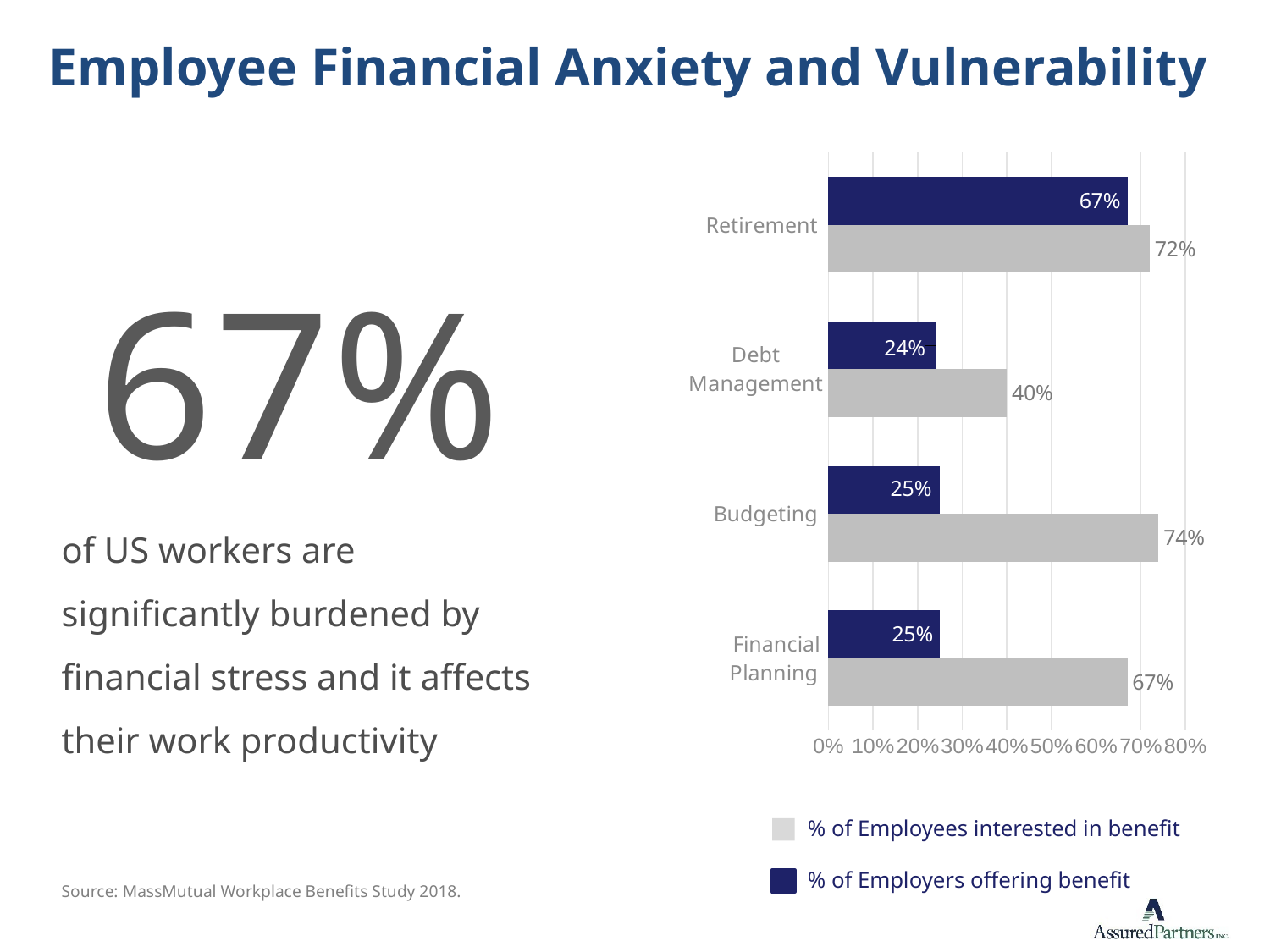
What percentage of employees are interested in a debt management benefit? 40% What is the difference between the percentage of employees interested in a retirement benefit and the percentage of employers offering it? 5% How many series does the chart legend list? 2 Which is larger for Financial Planning: the percentage of employees interested or the percentage of employers offering the benefit? % of Employees interested in benefit Which category has the highest percentage of employers offering the benefit? Retirement What percentage of employers offer a retirement benefit? 67% What percentage of employees are interested in a budgeting benefit? 74% How many benefit categories are shown in the chart? 4 What type of chart is shown on the slide? Bar chart Which category has the lowest percentage of employees interested in the benefit? Debt Management What is the difference between the percentage of employees interested in a budgeting benefit and the percentage of employers offering it? 49% Which colour represents the '% of Employers offering benefit' series? Dark blue